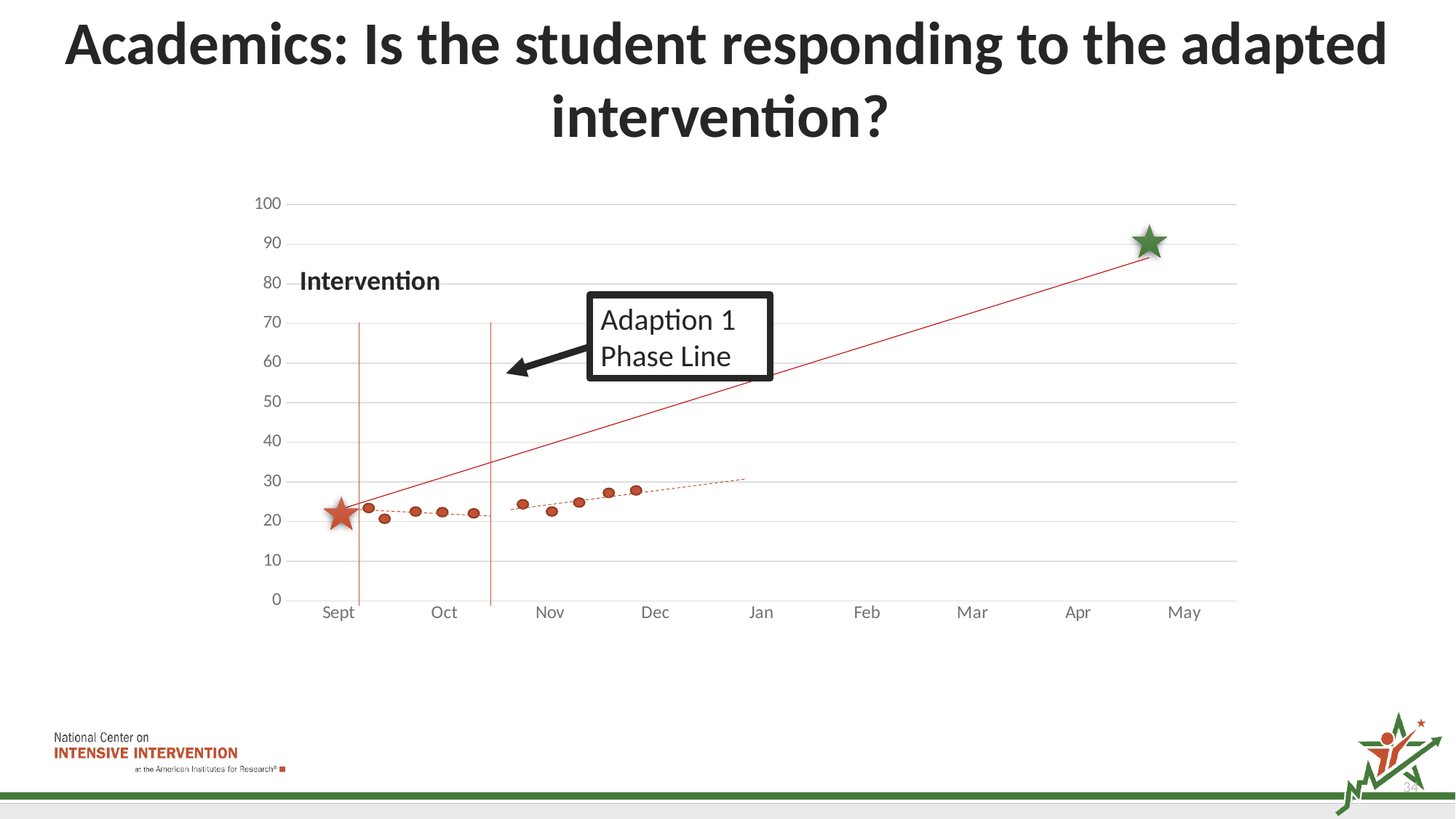
Does the solid red goal line rise or fall from Sept to May? rise How many months are labelled along the x axis of the chart? 9 What is the first month labelled on the x axis? Sept Are all of the plotted student data points greater or less than 40? less What is the last month labelled on the x axis? May What kind of chart is shown on the slide? line chart What is the highest value shown on the y axis? 100 Do the student data points after the Adaption 1 Phase Line rise or fall over time? rise What does the boxed label with the arrow identify on the chart? Adaption 1 Phase Line Is the value of the green star goal point in May greater or less than 80? greater Is the value of the red star starting point in Sept greater or less than 30? less